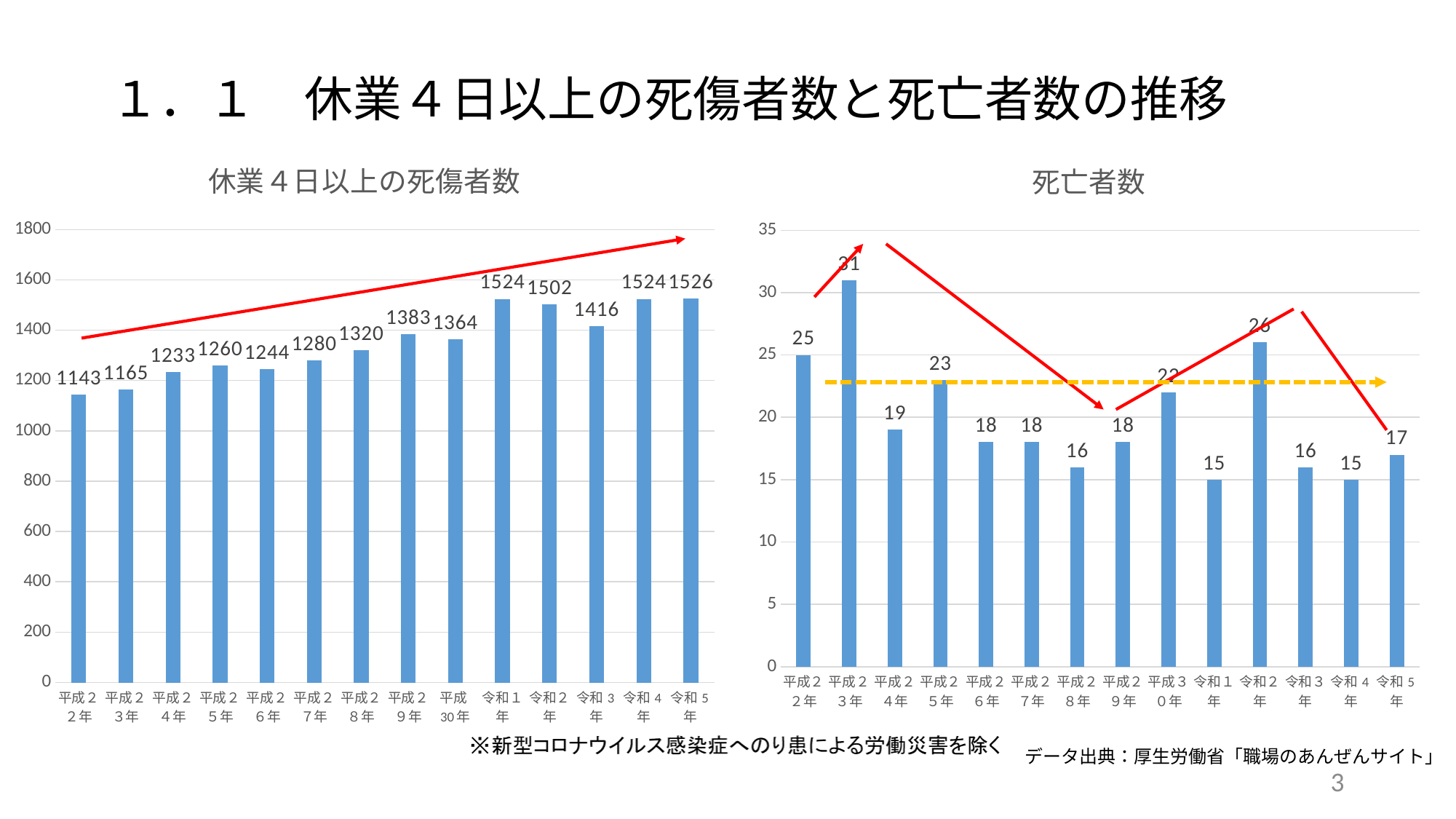
What is the title of the chart on the left side of the slide? 休業４日以上の死傷者数 In the 休業４日以上の死傷者数 chart, what is the value for 平成30年? 1364 What kind of chart is the 死亡者数 chart? bar chart In the 休業４日以上の死傷者数 chart, what is the value for 令和５年? 1526 In the 死亡者数 chart, which is larger, the value for 令和２年 or the value for 令和３年? 令和２年 In the 休業４日以上の死傷者数 chart, do the values generally rise or fall from 平成22年 to 令和５年? rise In the 休業４日以上の死傷者数 chart, which year has the lowest value? 平成22年 In the 死亡者数 chart, what is the difference between the values for 平成23年 and 令和５年? 14 In the 休業４日以上の死傷者数 chart, what is the difference between the values for 令和１年 and 平成22年? 381 In the 死亡者数 chart, what is the value for 平成23年? 31 In the 休業４日以上の死傷者数 chart, how many years are plotted? 14 In the 死亡者数 chart, which year has the highest value? 平成23年